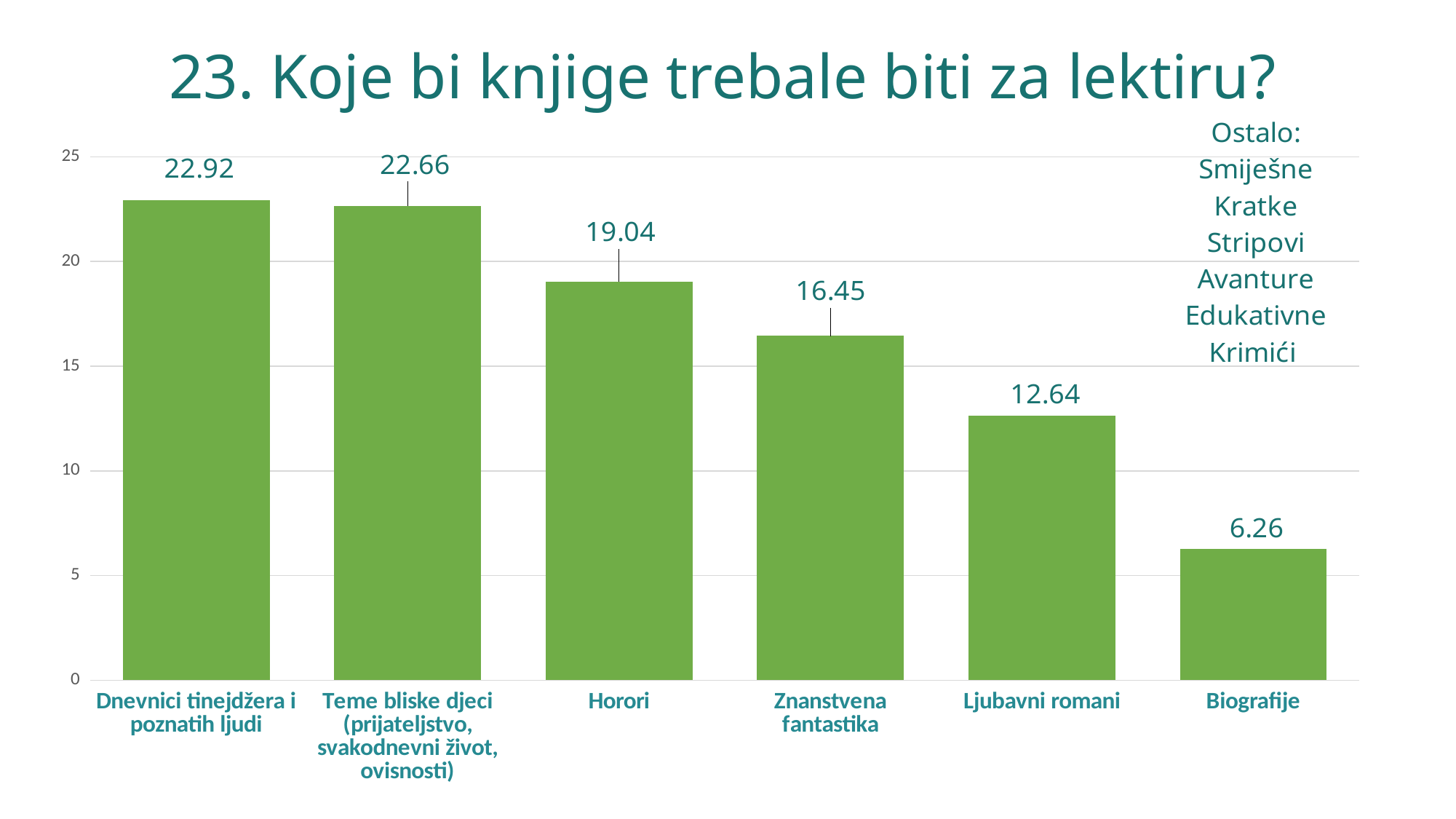
What is the value for Ljubavni romani? 12.64 What is the value for Znanstvena fantastika? 16.45 Which is larger, the value for Horori or the value for Ljubavni romani? Horori What is the value for Horori? 19.04 Which category has the lowest value? Biografije What is the value for Biografije? 6.26 What is the difference between the values for Dnevnici tinejdžera i poznatih ljudi and Biografije? 16.66 Is the value for Ljubavni romani greater or less than 15? less Which category has the highest value? Dnevnici tinejdžera i poznatih ljudi What kind of chart is shown on the slide? bar chart What is the difference between the values for Horori and Znanstvena fantastika? 2.59 How many categories are shown in the chart? 6